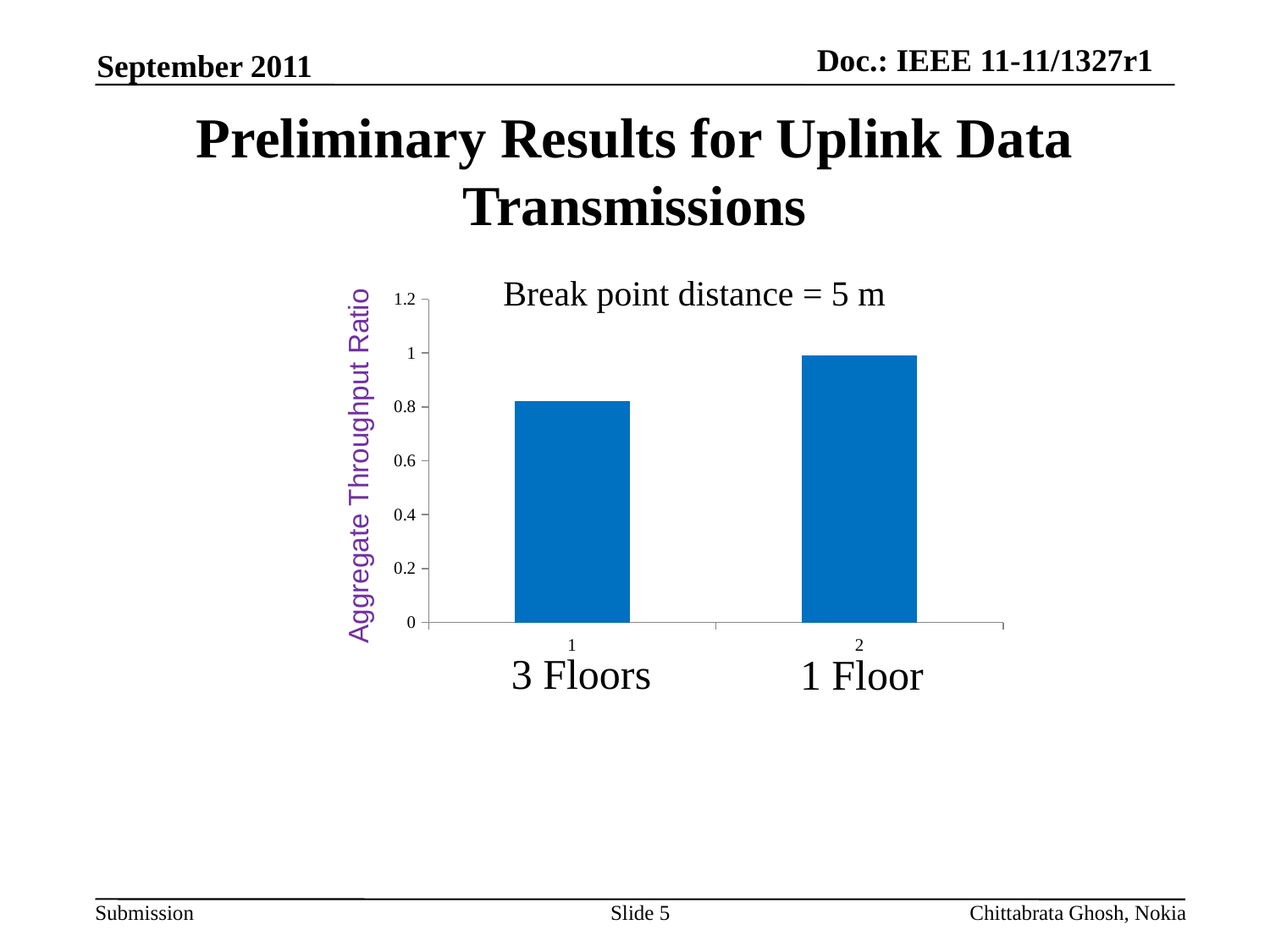
Is the value for 3 Floors greater or less than 1? less What is the label of the vertical axis? Aggregate Throughput Ratio What kind of chart is shown on the slide? bar chart Which category has the lowest aggregate throughput ratio? 3 Floors Is the value for 1 Floor greater or less than 0.8? greater How many bars are plotted in the chart? 2 Which is larger, the value for 3 Floors or the value for 1 Floor? 1 Floor Is the value for 3 Floors greater or less than 0.6? greater Which category has the highest aggregate throughput ratio? 1 Floor What is the title of the chart? Break point distance = 5 m